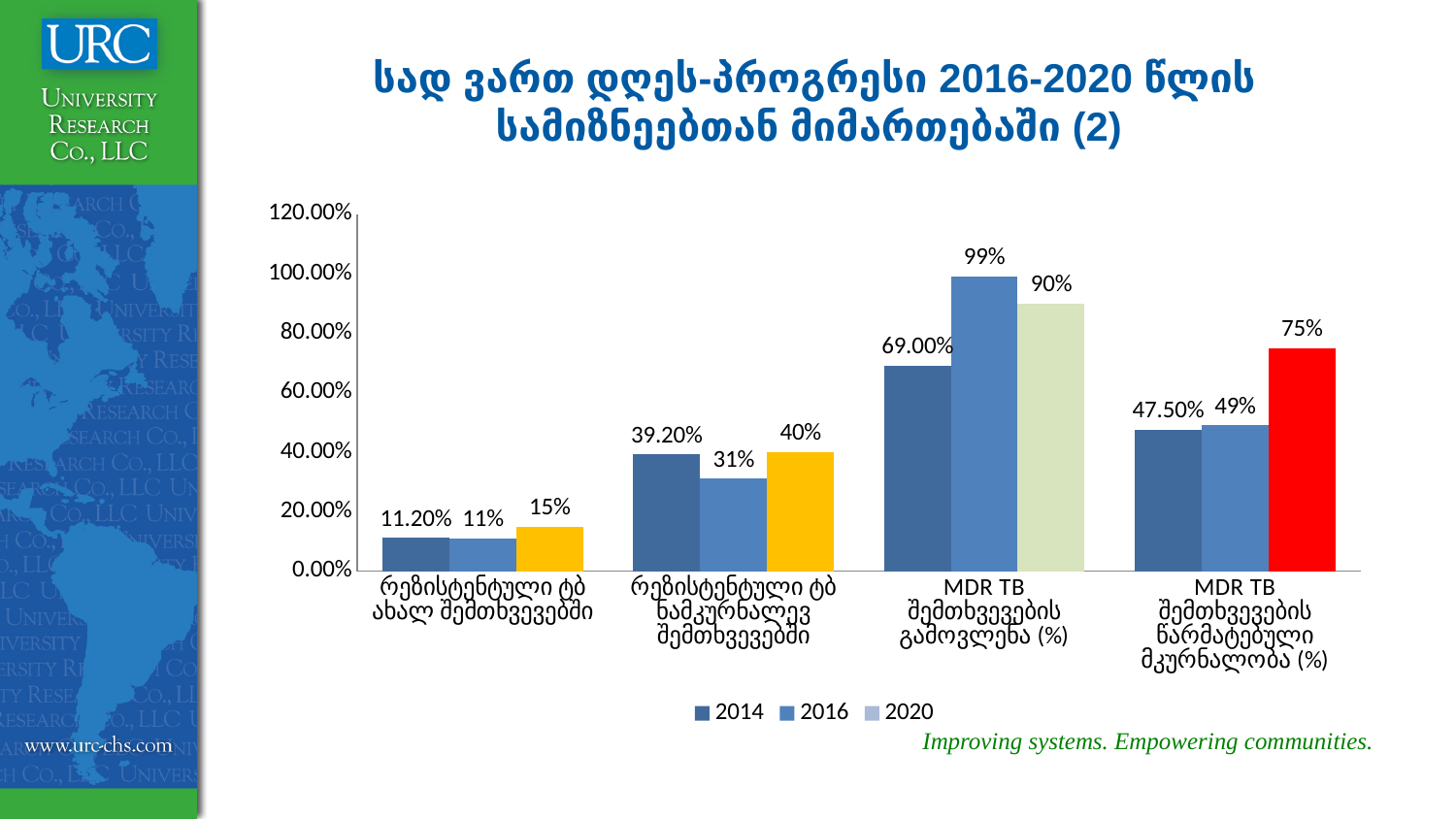
Which series is shown in the legend first? 2014 What kind of chart is shown on the slide? bar chart What is the 2014 value for რეზისტენტული ტბ ახალ შემთხვევებში? 11.20% What is the difference between the 2020 and 2014 values for MDR TB შემთხვევების წარმატებული მკურნალობა (%)? 27.50% What is the 2020 value for MDR TB შემთხვევების წარმატებული მკურნალობა (%)? 75% Which category has the lowest 2020 value? რეზისტენტული ტბ ახალ შემთხვევებში Which category has the highest 2016 value? MDR TB შემთხვევების გამოვლენა (%) What is the 2016 value for MDR TB შემთხვევების გამოვლენა (%)? 99% How many categories are shown on the x axis? 4 What is the 2016 value for რეზისტენტული ტბ ნამკურნალევ შემთხვევებში? 31% For MDR TB შემთხვევების გამოვლენა (%), which is larger: the 2016 value or the 2020 value? 2016 How many series does the legend list? 3